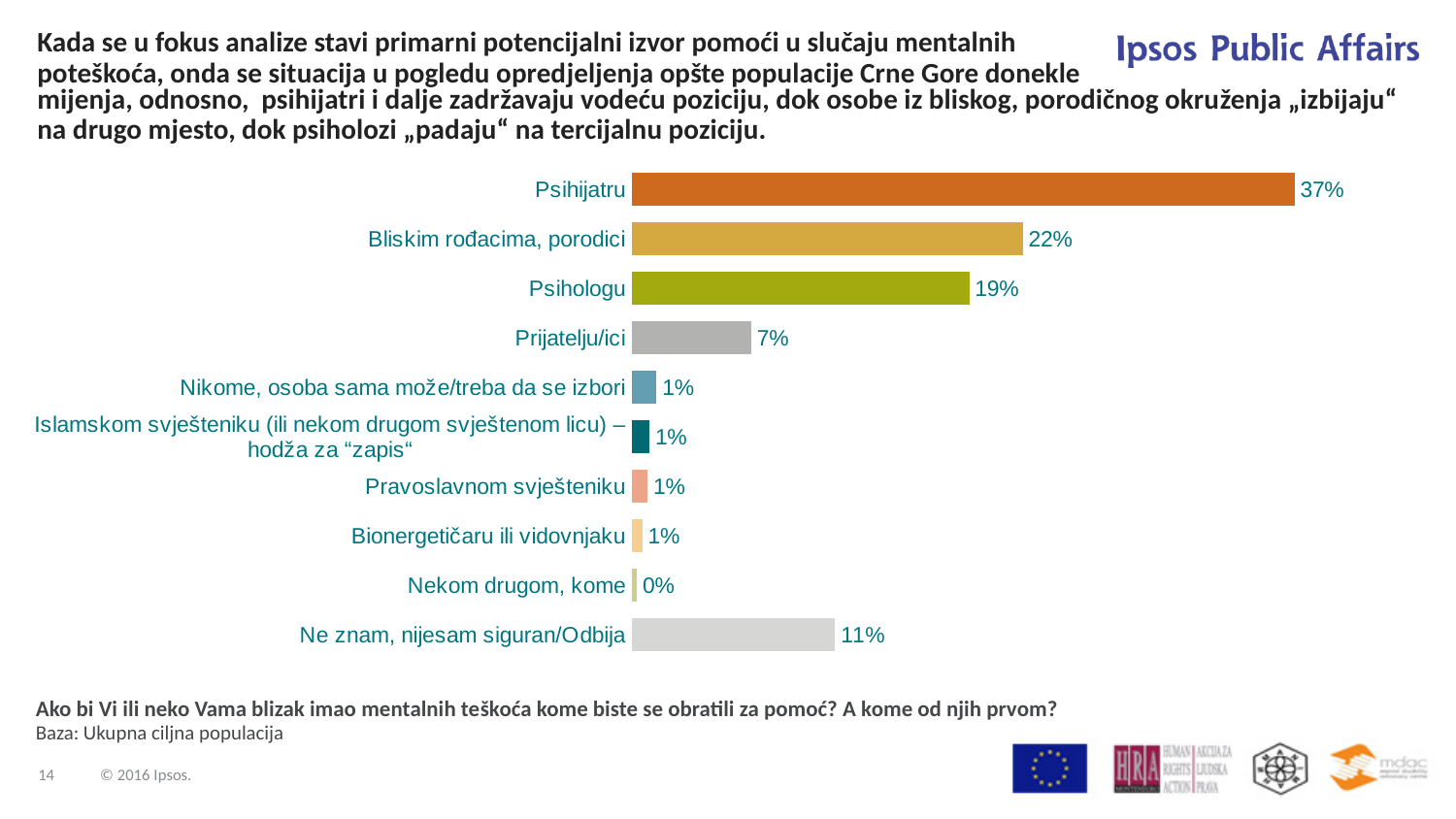
What kind of chart is shown on the slide? Bar chart How many categories are shown in the chart? 10 Which is larger, the value for Psihologu or the value for Ne znam, nijesam siguran/Odbija? Psihologu Which category has the lowest value? Nekom drugom, kome What is the value for Prijatelju/ici? 7% Which category has the highest value? Psihijatru What is the value for Bliskim rođacima, porodici? 22% What is the value for Ne znam, nijesam siguran/Odbija? 11% What is the value for Psihijatru? 37% What is the value for Psihologu? 19% What is the difference between the values for Psihologu and Prijatelju/ici? 12% What is the difference between the values for Psihijatru and Bliskim rođacima, porodici? 15%